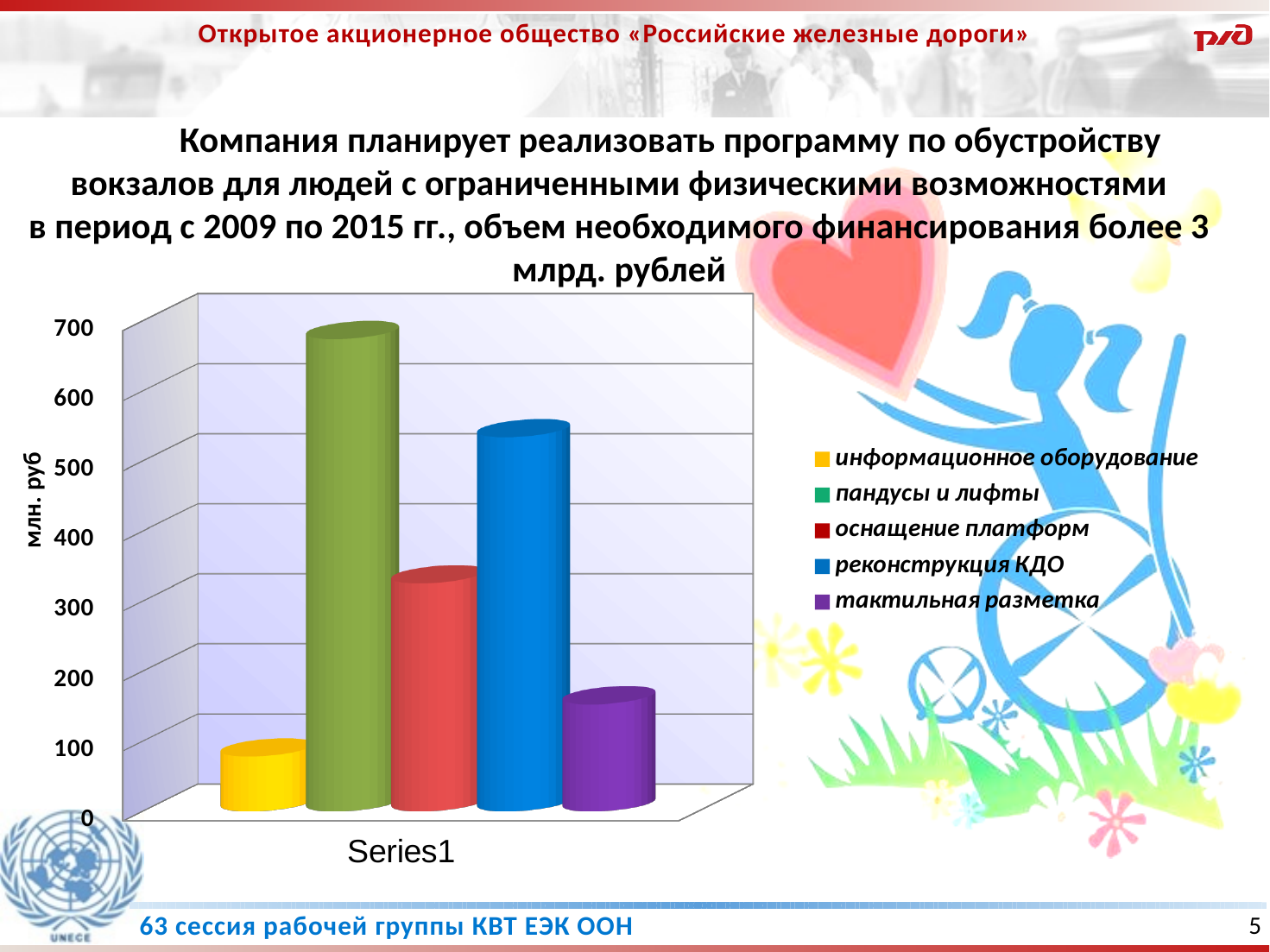
Which is larger, the value for тактильная разметка or the value for информационное оборудование? тактильная разметка Is the value for информационное оборудование greater or less than 200? less Which is larger, the value for реконструкция КДО or the value for оснащение платформ? реконструкция КДО What is the label on the vertical axis of the chart? млн. руб Is the value for реконструкция КДО greater or less than 400? greater Is the value for оснащение платформ greater or less than 400? less How many bars are plotted in the chart? 5 Which category has the lowest bar in the chart? информационное оборудование Which category has the highest bar in the chart? пандусы и лифты How many entries does the chart legend list? 5 What kind of chart is shown on the slide? bar chart